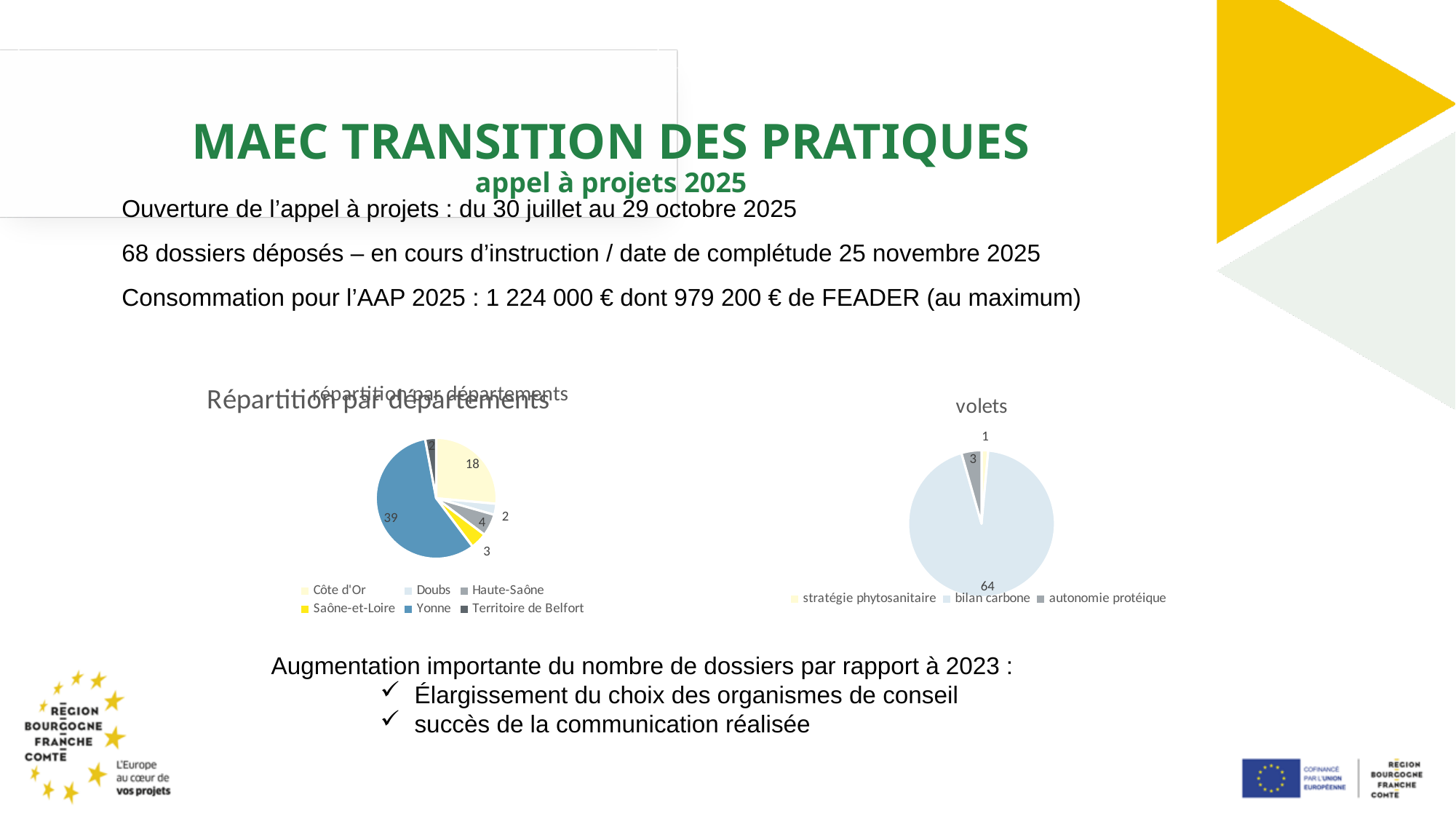
In the 'répartition par départements' chart, what is the value for Côte d'Or? 18 In the 'répartition par départements' chart, which is larger, Haute-Saône or Saône-et-Loire? Haute-Saône In the 'répartition par départements' chart, what is the value for Yonne? 39 In the 'répartition par départements' chart, which department has the largest slice? Yonne What type of chart is the 'volets' chart? Pie chart How many categories does the legend of the 'répartition par départements' chart list? 6 In the 'volets' chart, which category has the smallest slice? stratégie phytosanitaire In the 'volets' chart, what is the value for autonomie protéique? 3 In the 'répartition par départements' chart, what is the difference between the values for Yonne and Côte d'Or? 21 How many categories does the legend of the 'volets' chart list? 3 In the 'volets' chart, what is the value for bilan carbone? 64 What is the total of all slices in the 'volets' chart? 68